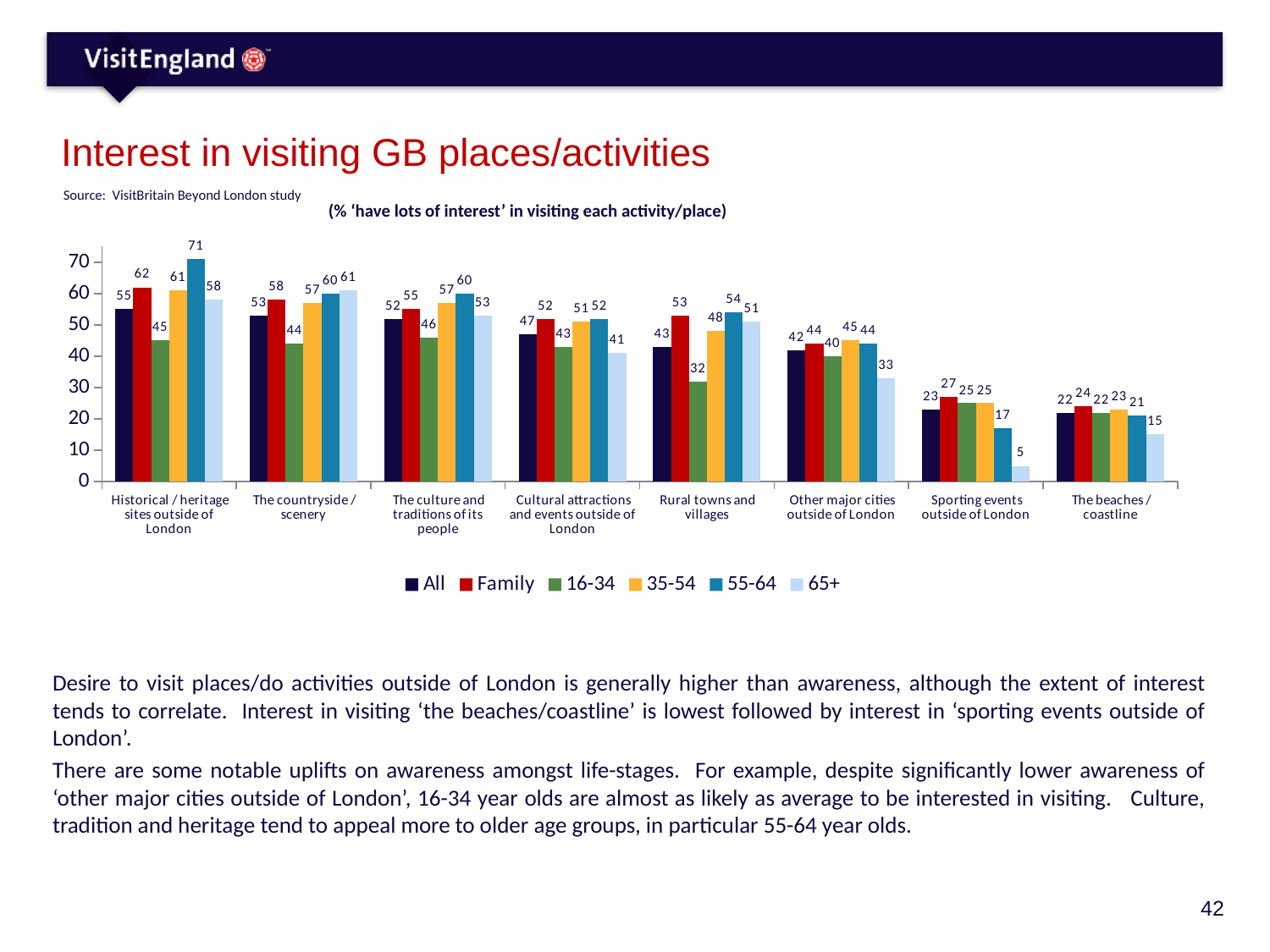
What is the value for the 'All' series for 'The countryside / scenery'? 53 How many series does the legend list? 6 What is the subtitle shown above the chart? (% 'have lots of interest' in visiting each activity/place) Which is larger for 'Other major cities outside of London': the Family value or the 65+ value? Family Which category has the highest value for the 'All' series? Historical / heritage sites outside of London What is the difference between the 55-64 and 16-34 values for 'Historical / heritage sites outside of London'? 26 What kind of chart is shown on the slide? Bar chart What is the value for the 16-34 series for 'Rural towns and villages'? 32 What is the value for the 55-64 series for 'Historical / heritage sites outside of London'? 71 How many categories are shown on the x axis? 8 Which category has the lowest value for the 65+ series? Sporting events outside of London What is the value for the 65+ series for 'Sporting events outside of London'? 5